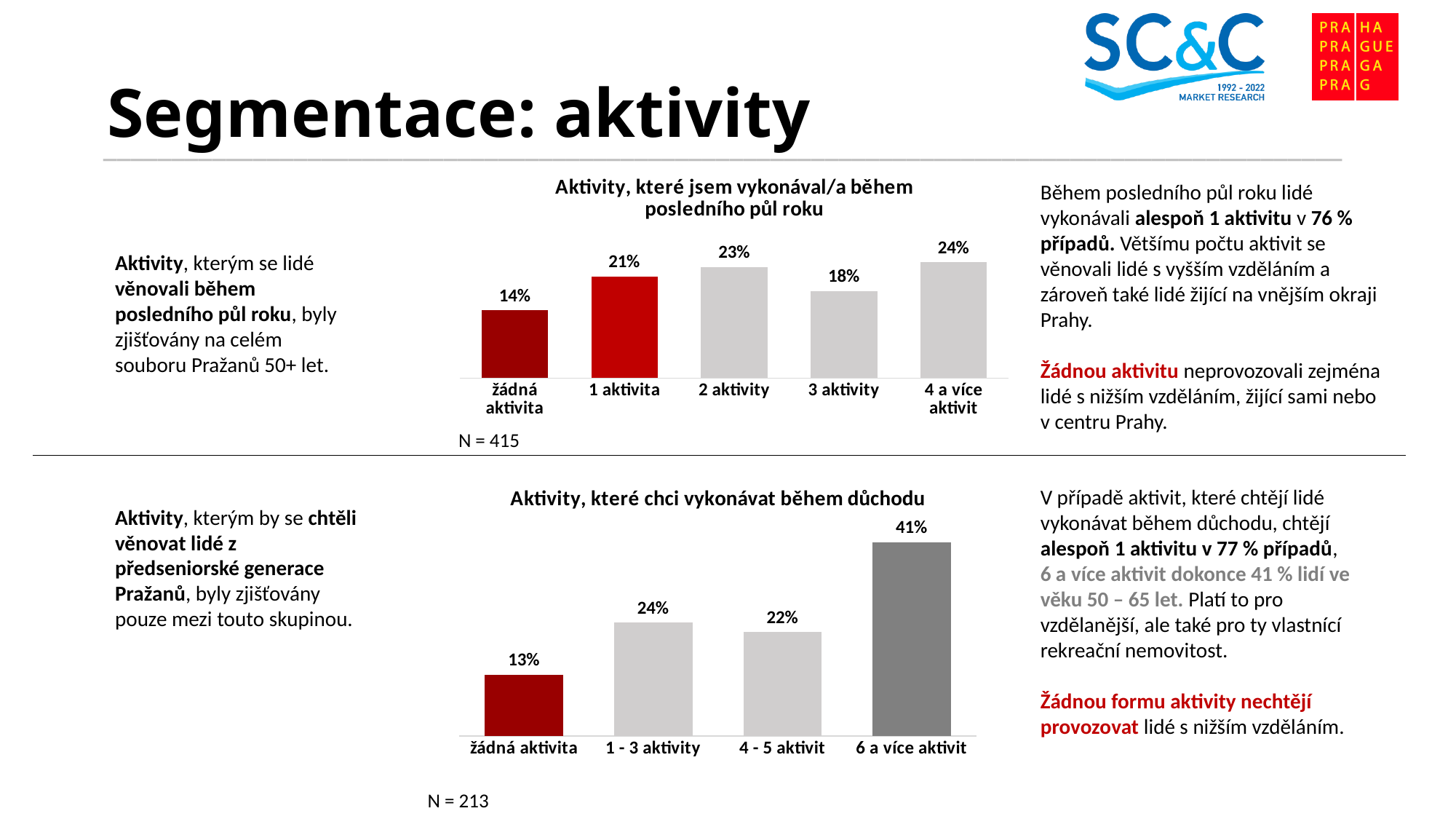
What is the sample size (N) shown below the top chart 'Aktivity, které jsem vykonával/a během posledního půl roku'? N = 415 In the top chart 'Aktivity, které jsem vykonával/a během posledního půl roku', what is the difference between '1 aktivita' and '3 aktivity'? 3% In the bottom chart 'Aktivity, které chci vykonávat během důchodu', which is larger: '1 - 3 aktivity' or '4 - 5 aktivit'? 1 - 3 aktivity In the bottom chart 'Aktivity, které chci vykonávat během důchodu', what is the difference between '6 a více aktivit' and 'žádná aktivita'? 28% In the top chart 'Aktivity, které jsem vykonával/a během posledního půl roku', how many categories are shown? 5 In the top chart 'Aktivity, které jsem vykonával/a během posledního půl roku', which category has the lowest value? žádná aktivita What type of chart is the bottom chart 'Aktivity, které chci vykonávat během důchodu'? Bar chart In the top chart 'Aktivity, které jsem vykonával/a během posledního půl roku', which category has the highest value? 4 a více aktivit In the top chart 'Aktivity, které jsem vykonával/a během posledního půl roku', what is the value for '2 aktivity'? 23% In the bottom chart 'Aktivity, které chci vykonávat během důchodu', what is the value for 'žádná aktivita'? 13% In the bottom chart 'Aktivity, které chci vykonávat během důchodu', how many categories are shown? 4 In the bottom chart 'Aktivity, které chci vykonávat během důchodu', what is the value for '6 a více aktivit'? 41%